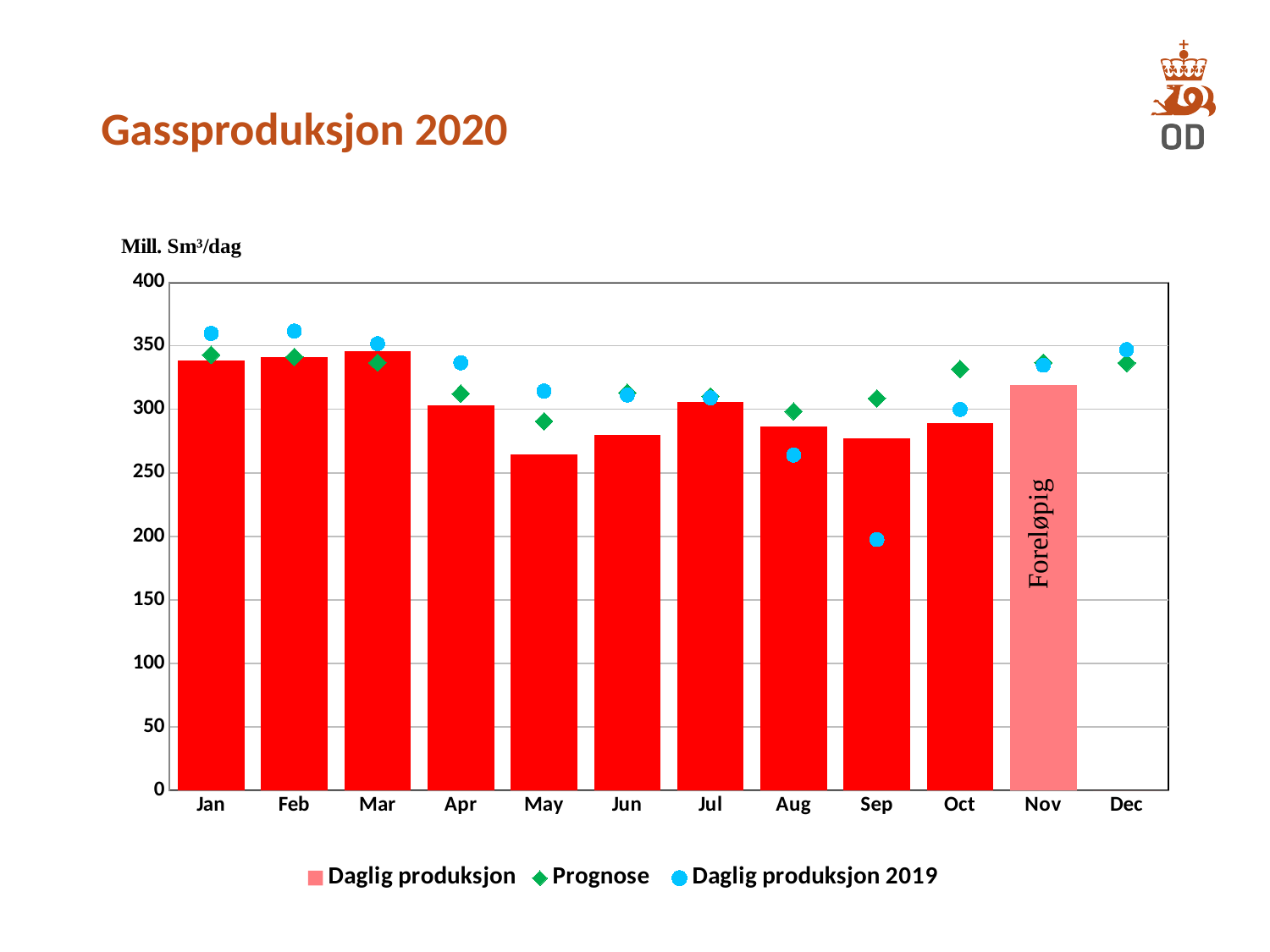
Which is larger, the Daglig produksjon bar for Jan or for May? Jan Is the Daglig produksjon value for Mar greater or less than 300? greater What word is written on the Nov bar? Foreløpig Which month has the lowest Daglig produksjon bar? May Is the Daglig produksjon 2019 value for Aug greater or less than 300? less Is the Daglig produksjon value for May greater or less than 300? less How many series does the legend list? 3 Do the Daglig produksjon bars rise or fall from Jan to May? fall What kind of chart is shown on the slide? bar chart How many months are shown on the x axis? 12 What unit is shown above the y axis? Mill. Sm³/dag